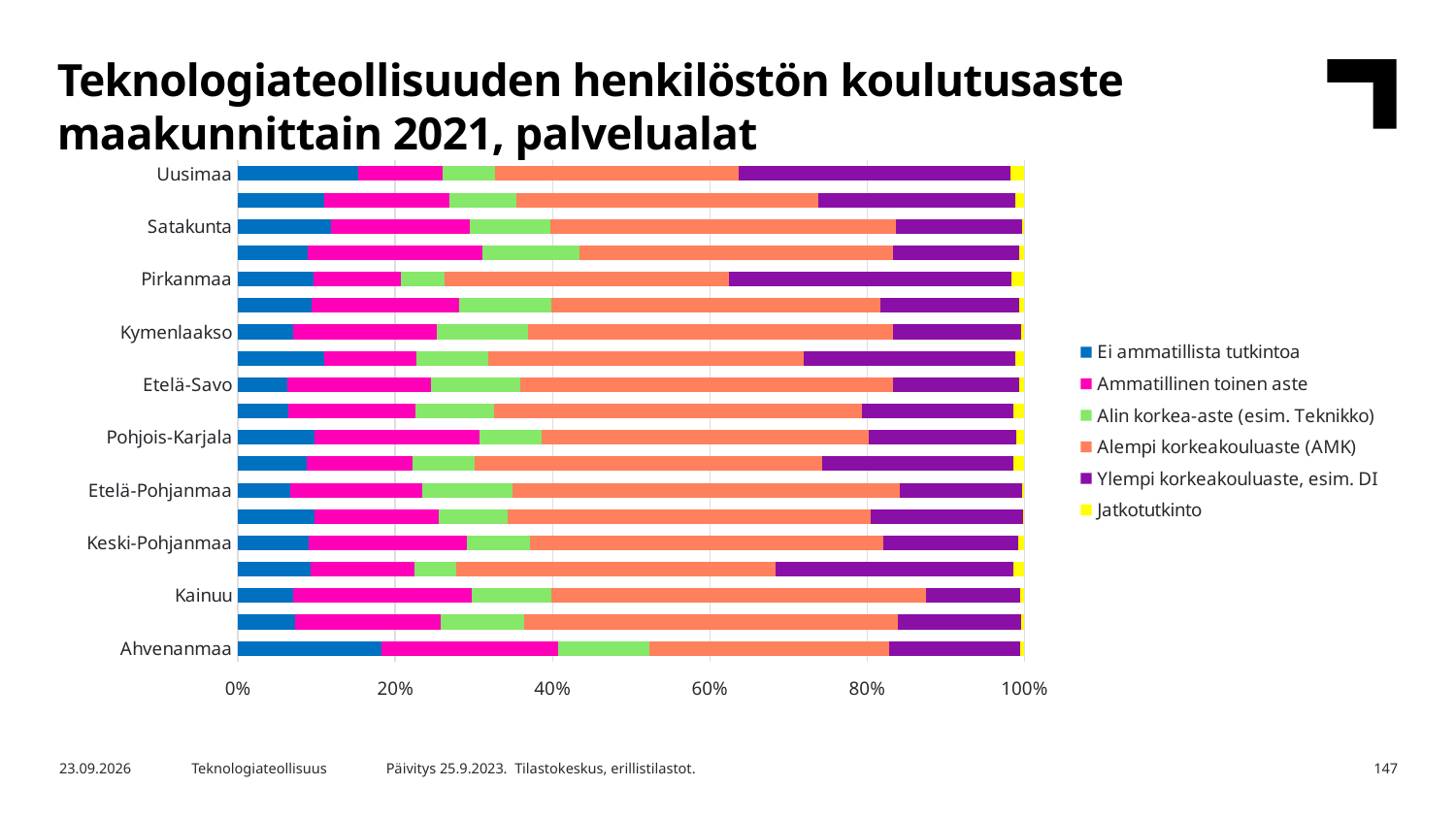
Which has the larger 'Ei ammatillista tutkintoa' share, Ahvenanmaa or Kainuu? Ahvenanmaa What kind of chart is shown on the slide? Stacked bar chart What is the maximum value shown on the horizontal axis? 100% How many bars are plotted in the chart? 19 Which legend entry is shown in yellow? Jatkotutkinto How many series does the legend list? 6 Is the 'Ei ammatillista tutkintoa' share for Uusimaa greater or less than 20%? less Is the cumulative share up to and including 'Alempi korkeakouluaste (AMK)' for Kainuu greater or less than 80%? greater What is the title of the chart on the slide? Teknologiateollisuuden henkilöstön koulutusaste maakunnittain 2021, palvelualat Is the 'Ei ammatillista tutkintoa' share for Ahvenanmaa greater or less than 20%? less